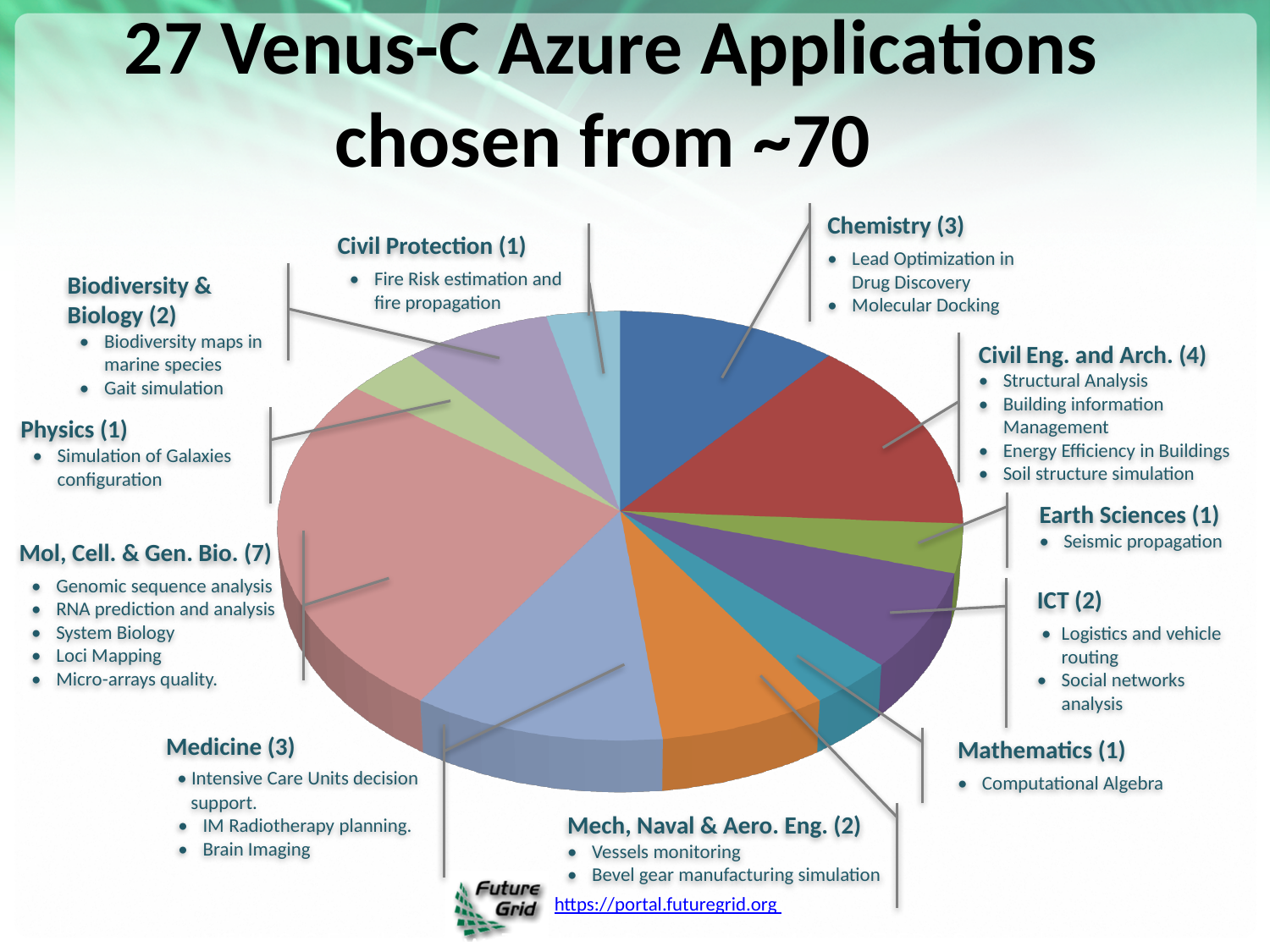
What is the title of the slide containing the chart? 27 Venus-C Azure Applications chosen from ~70 Which category has the largest number of applications in the pie chart? Mol, Cell. & Gen. Bio. What kind of chart is shown on the slide? Pie chart How many applications does the pie chart show for Mol, Cell. & Gen. Bio.? 7 Which has more applications, Chemistry or Mech, Naval & Aero. Eng.? Chemistry What is the difference between the number of applications for Mol, Cell. & Gen. Bio. and for Civil Eng. and Arch.? 3 How many applications are listed for Chemistry? 3 What is the difference between the number of applications for Civil Eng. and Arch. and for Chemistry? 1 How many categories (slices) does the pie chart have? 11 How many applications are listed for Medicine? 3 How many applications are listed for Civil Eng. and Arch.? 4 Which has more applications, Medicine or ICT? Medicine